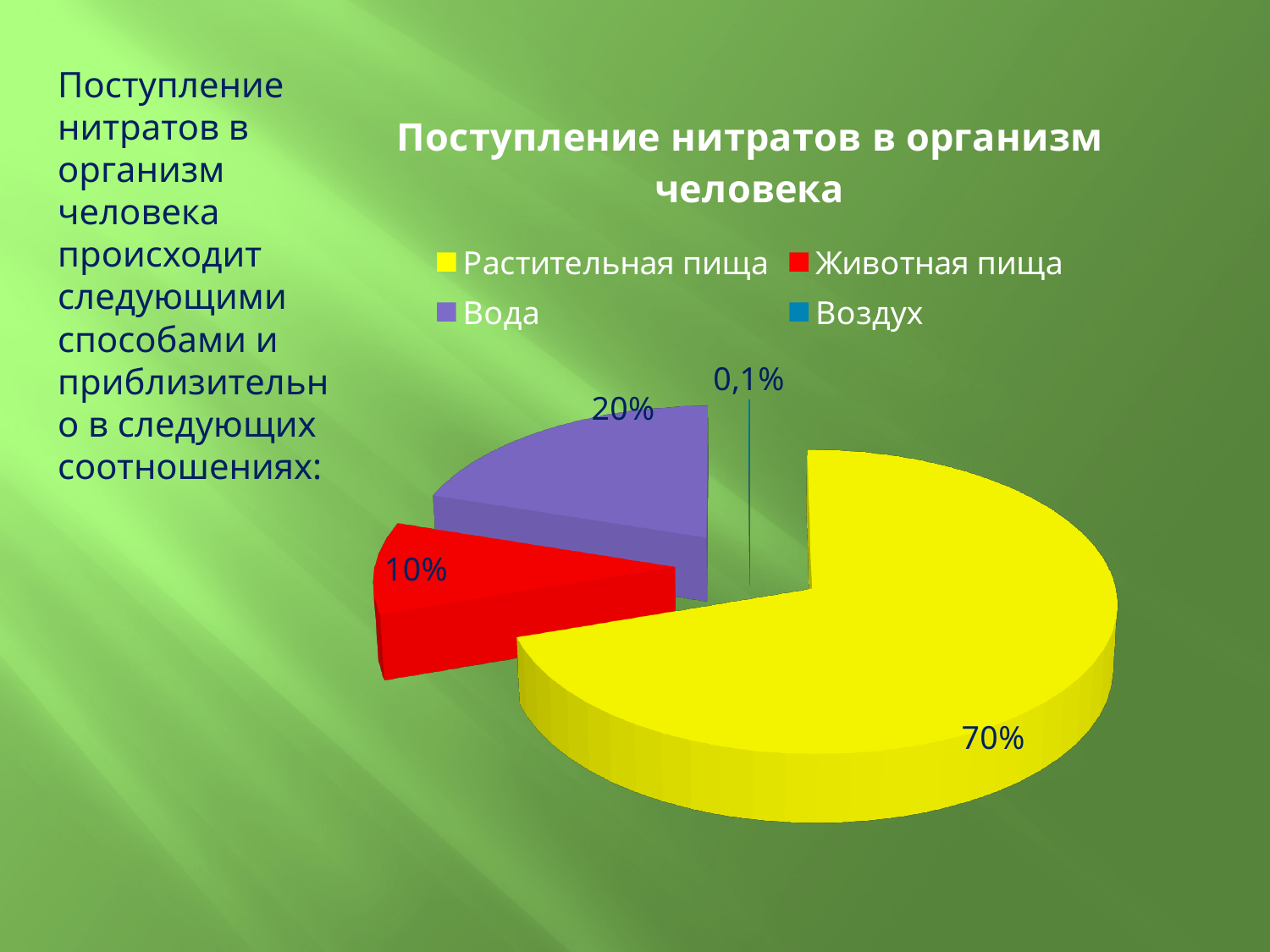
Which category has the largest slice of the pie? Растительная пища What is the difference between the shares for Растительная пища and Вода? 50% What share of the pie is labelled for Животная пища? 10% What is the title of the chart? Поступление нитратов в организм человека Which category has the smallest slice of the pie? Воздух What share of the pie is labelled for Растительная пища? 70% What share of the pie is labelled for Воздух? 0,1% What colour is the slice for Животная пища? red How many categories does the legend of the pie chart list? 4 Which is larger, the slice for Вода or the slice for Животная пища? Вода What kind of chart is shown on the slide? pie chart What share of the pie is labelled for Вода? 20%